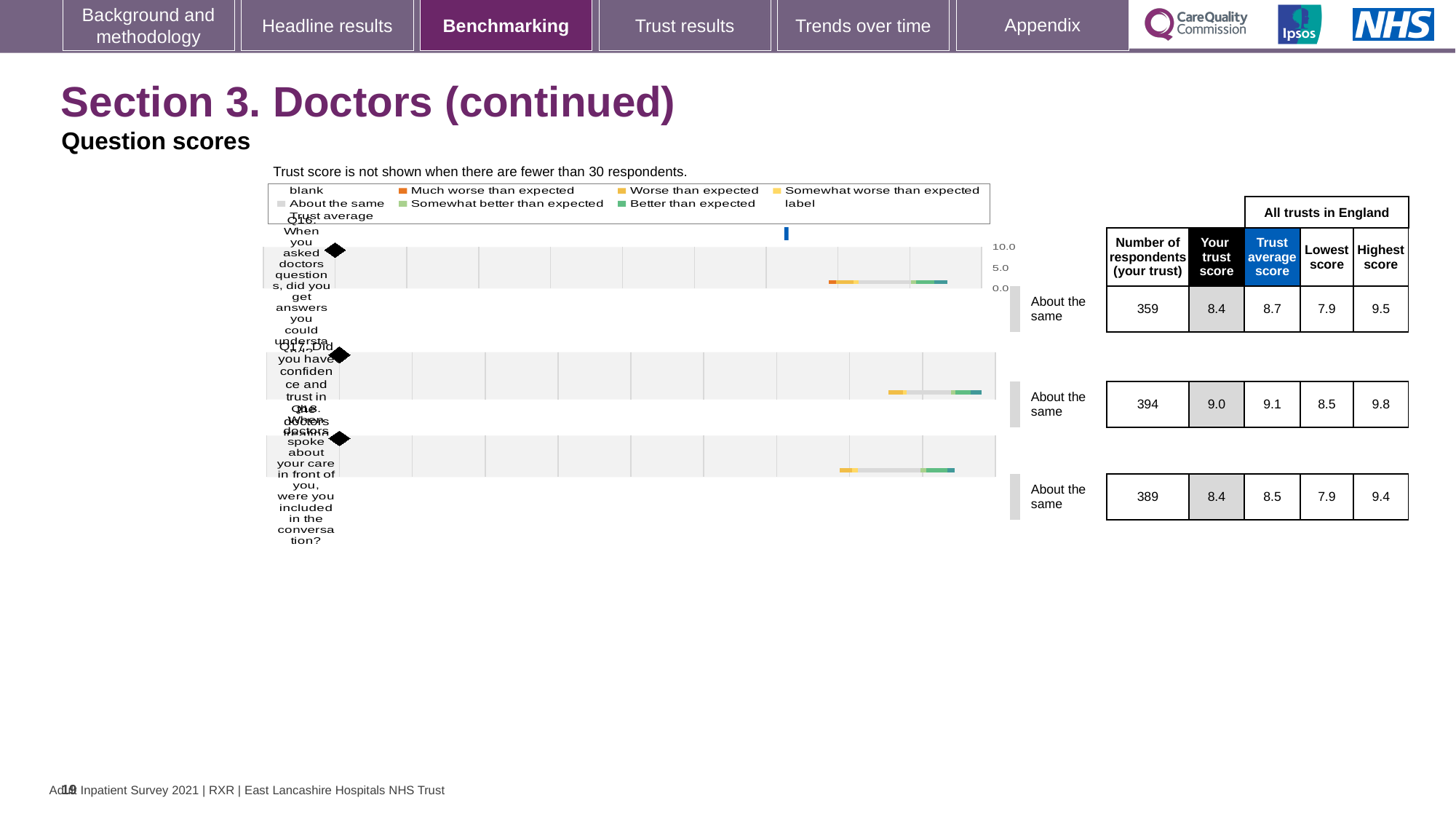
What is the highest score across all trusts in England for Q17? 9.8 How many respondents from your trust answered Q16? 359 What is the lowest score across all trusts in England for Q16? 7.9 Which question has the highest 'Your trust score'? Q17 What is the difference between the highest score and the lowest score for Q17? 1.3 How many questions (categories) are plotted in the chart? 3 Which question has the largest number of respondents? Q17 What kind of chart is used to show the question scores on this slide? bar chart For Q16, which is larger: your trust score or the trust average score? Trust average score What is the trust average score for Q18? 8.5 What is the 'Your trust score' for Q17 (Did you have confidence and trust in the doctors)? 9.0 What benchmark category is shown for all three questions on this slide? About the same